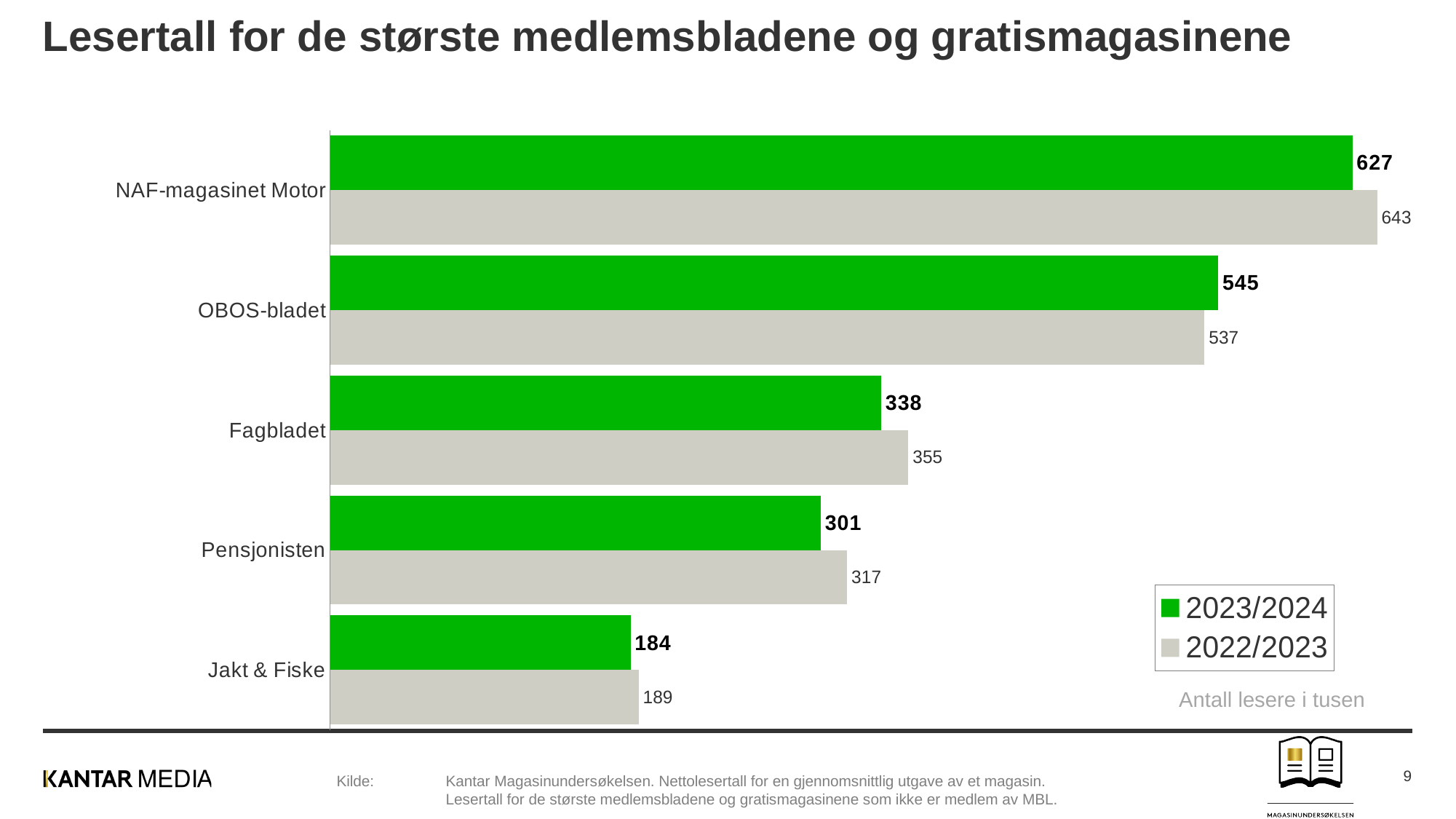
For Pensjonisten, which is larger: the 2023/2024 value or the 2022/2023 value? 2022/2023 What is the 2022/2023 value for Fagbladet? 355 Which magazine has the highest 2023/2024 value? NAF-magasinet Motor How many magazines are shown in the chart? 5 What is the 2023/2024 value for NAF-magasinet Motor? 627 Which magazine has the lowest 2022/2023 value? Jakt & Fiske What is the difference between the 2023/2024 and 2022/2023 values for OBOS-bladet? 8 What kind of chart is shown on the slide? Bar chart What unit does the chart say the values are in? Antall lesere i tusen How many series does the legend list? 2 What is the difference between the 2022/2023 and 2023/2024 values for NAF-magasinet Motor? 16 What is the 2023/2024 value for Jakt & Fiske? 184